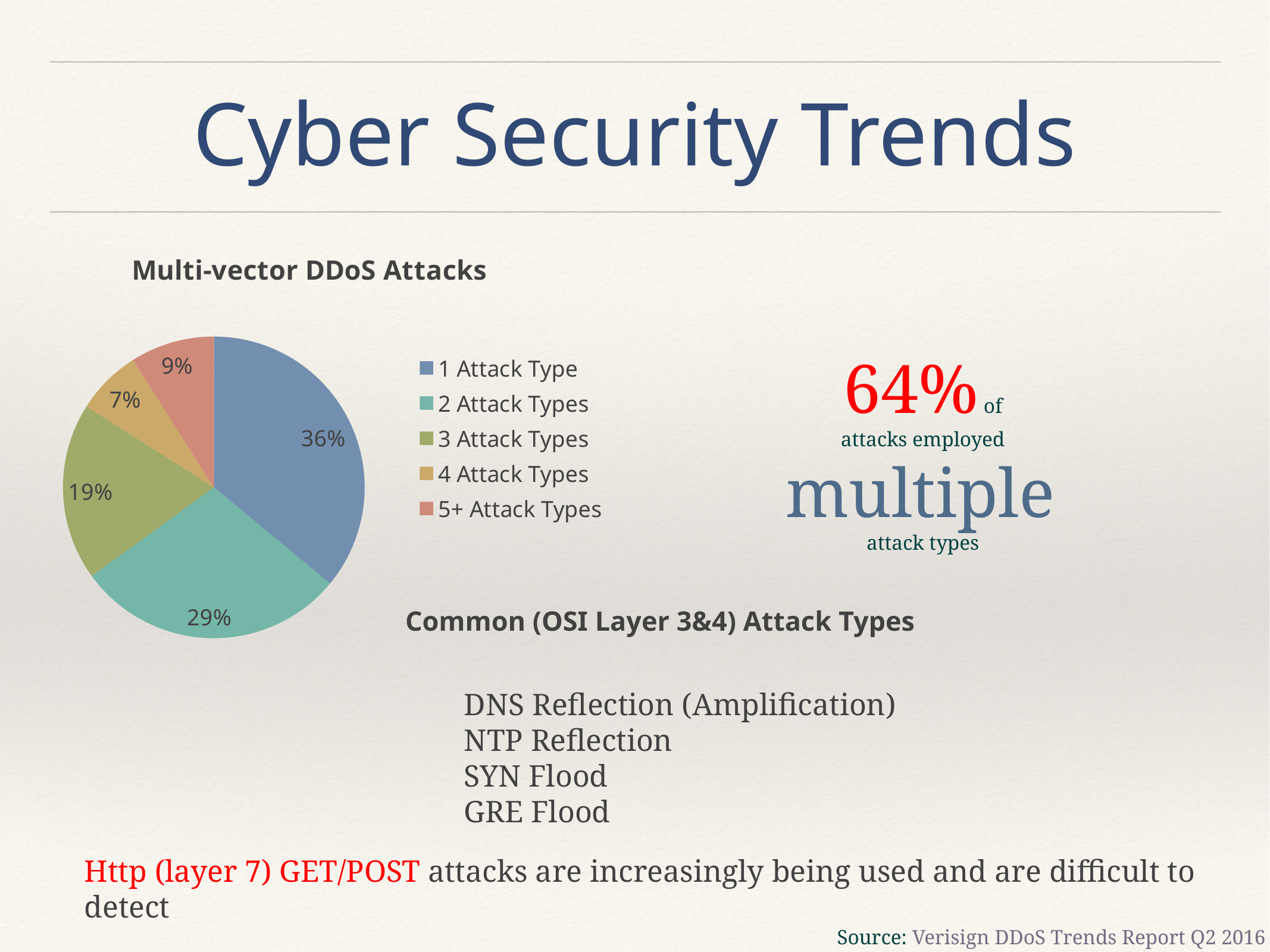
What is the title of the chart? Multi-vector DDoS Attacks Which category has the largest slice of the pie? 1 Attack Type How many categories does the legend list? 5 Which is larger, the share for 5+ Attack Types or the share for 4 Attack Types? 5+ Attack Types Which category has the smallest slice of the pie? 4 Attack Types What share of attacks used 2 Attack Types? 29% What is the difference between the share for 1 Attack Type and the share for 2 Attack Types? 7% What type of chart is shown on the slide? pie chart What share of attacks used 5+ Attack Types? 9% What share of attacks used 4 Attack Types? 7% What share of attacks used 1 Attack Type? 36% What share of attacks used 3 Attack Types? 19%